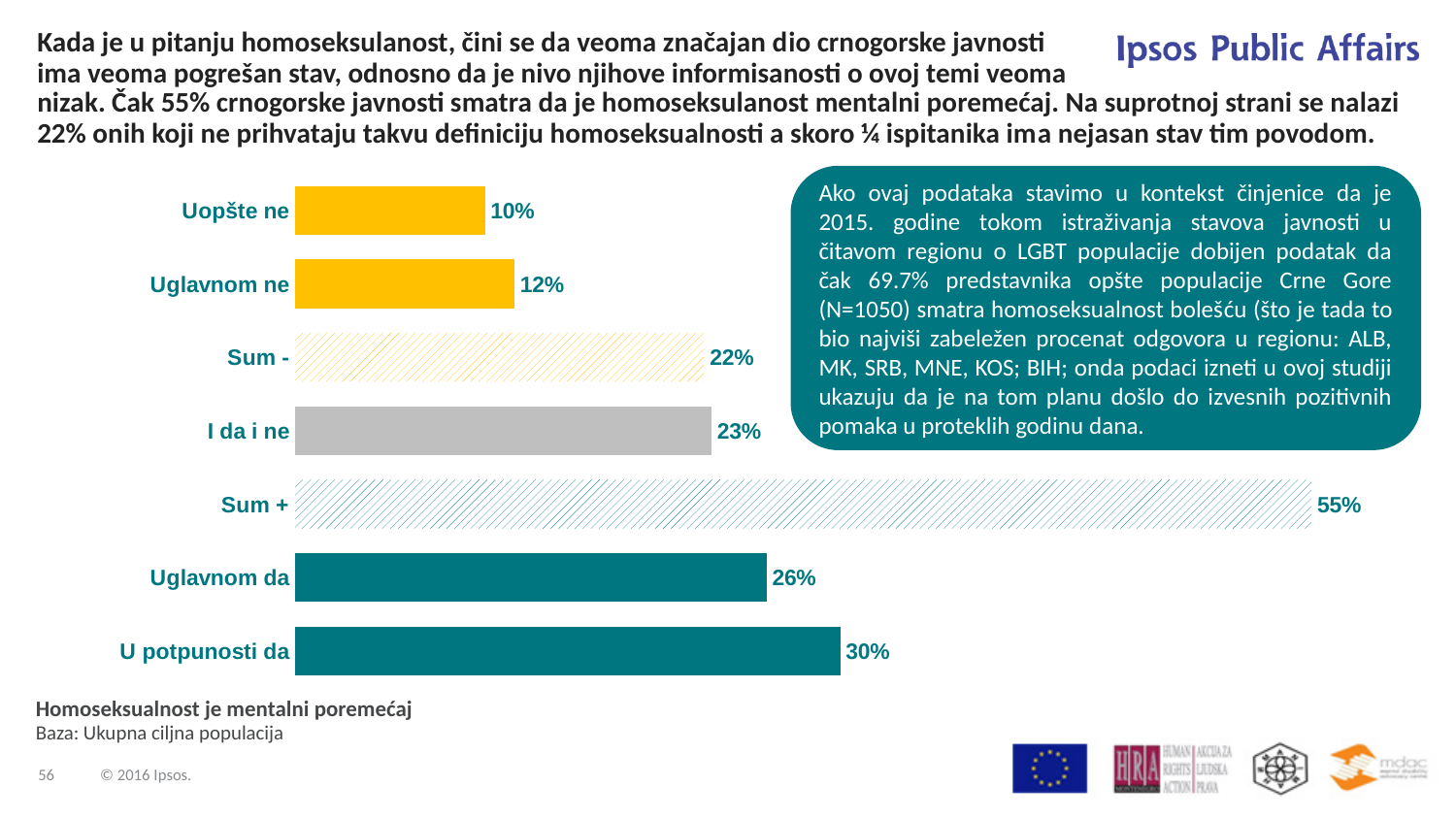
What is the value for "Sum +"? 55% Which is larger, "Uglavnom ne" or "Uglavnom da"? Uglavnom da Which category has the lowest value? Uopšte ne What is the title of the chart shown below the bars? Homoseksualnost je mentalni poremećaj What is the value for "I da i ne"? 23% What is the value for "U potpunosti da"? 30% What is the value for "Uopšte ne"? 10% What is the difference between "U potpunosti da" and "Uglavnom da"? 4% Which category has the highest value? Sum + What kind of chart is shown on the slide? Bar chart What is the difference between "Sum +" and "Sum -"? 33% How many categories are shown in the chart? 7